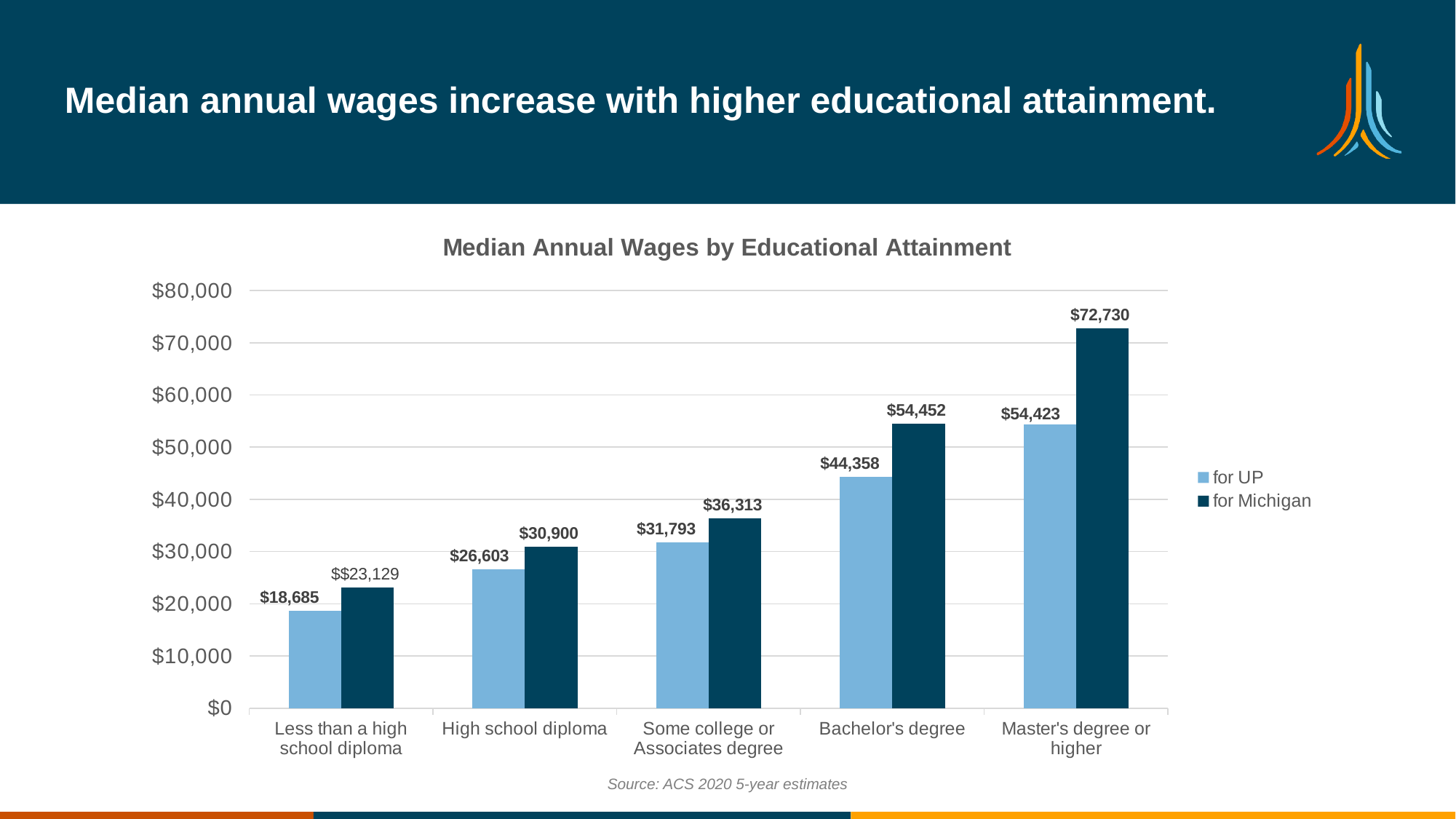
How many series does the legend list? 2 Which educational attainment category has the highest median annual wage for Michigan? Master's degree or higher Which is larger: the UP wage for Master's degree or higher, or the Michigan wage for Bachelor's degree? Michigan wage for Bachelor's degree What is the difference between the Michigan and UP median annual wages for Bachelor's degree? $10,094 Is the UP median annual wage for Some college or Associates degree greater or less than $30,000? greater Which educational attainment category has the lowest median annual wage for UP? Less than a high school diploma Do the median annual wages rise or fall as educational attainment increases along the x axis? rise What is the median annual wage for Michigan for Some college or Associates degree? $36,313 What is the median annual wage for UP for High school diploma? $26,603 What is the median annual wage for Michigan for Master's degree or higher? $72,730 How many educational attainment categories are shown on the x axis? 5 What is the median annual wage for UP for Bachelor's degree? $44,358